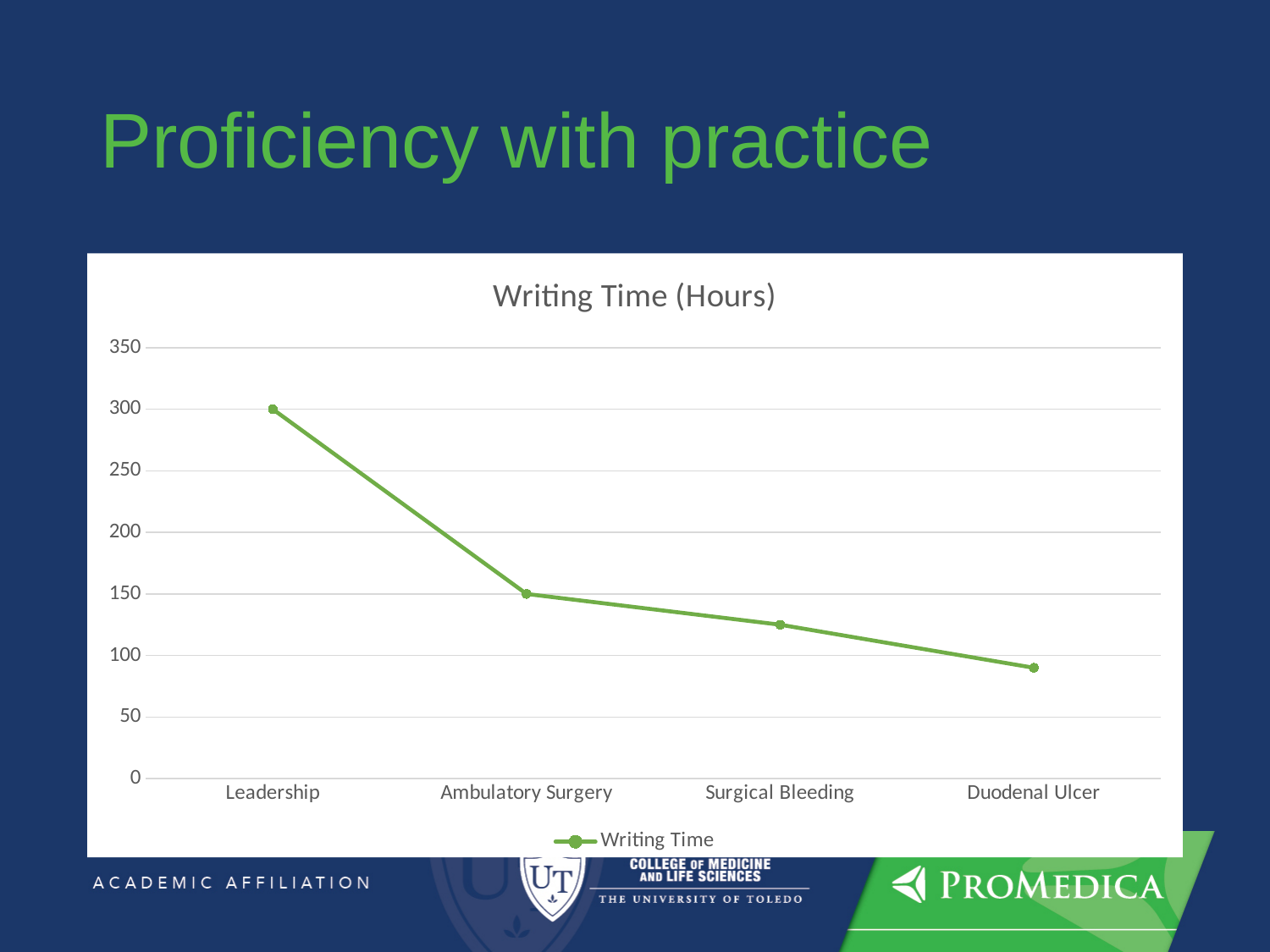
How many categories are plotted along the x axis? 4 What is the writing time for Ambulatory Surgery? 150 Do the writing time values rise or fall from Leadership to Duodenal Ulcer? fall Which category has the highest writing time? Leadership What is the title of the chart? Writing Time (Hours) Which category has the lowest writing time? Duodenal Ulcer What is the difference in writing time between Leadership and Ambulatory Surgery? 150 How many series does the legend list? 1 What kind of chart is shown on the slide? line chart What is the writing time for Leadership? 300 Is the writing time for Duodenal Ulcer greater or less than 100? less Is the writing time for Surgical Bleeding greater or less than 100? greater